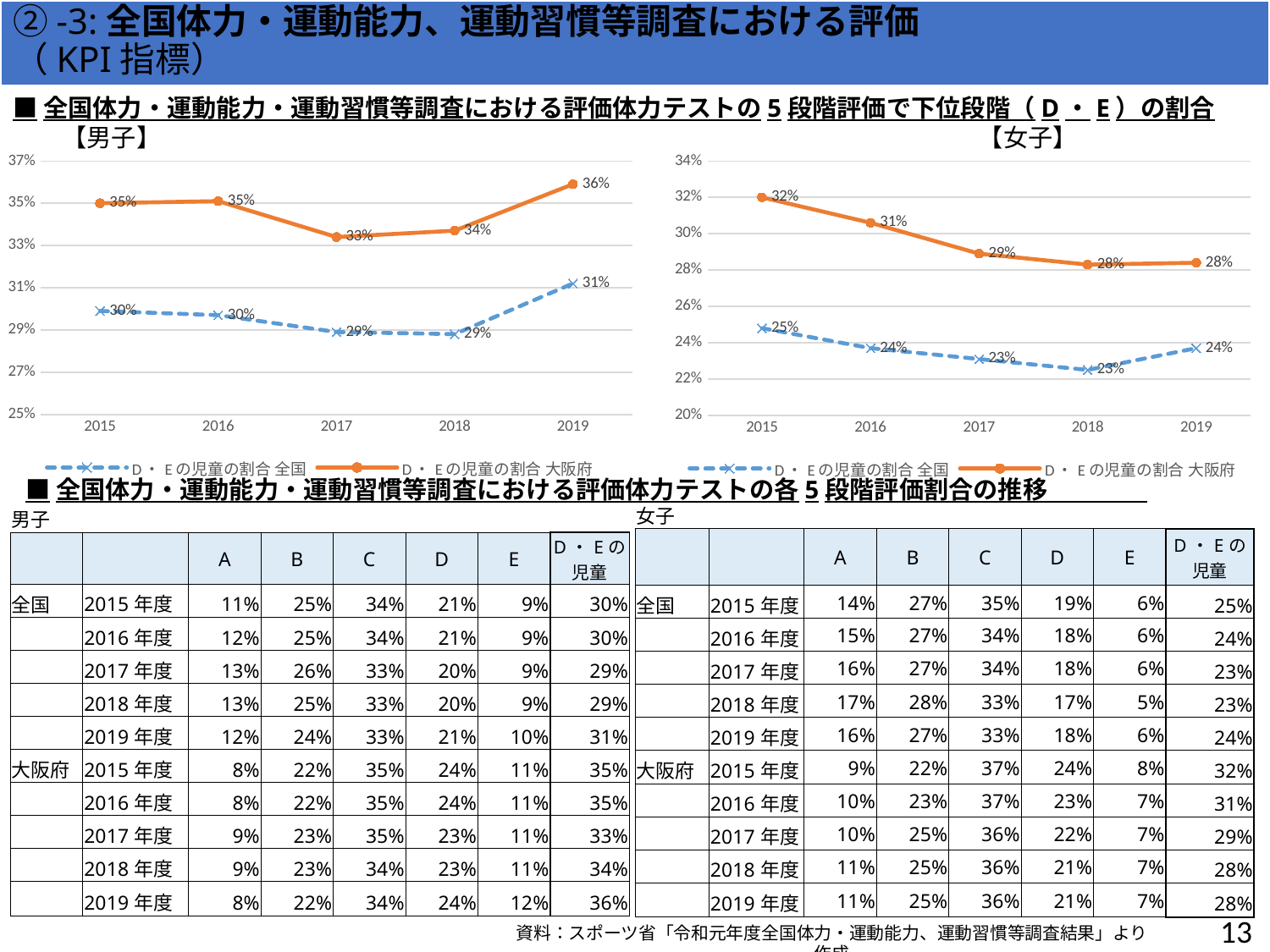
【女子】のグラフで、2015年の「D・Eの児童の割合 大阪府」の値はいくつですか？ 32% 【男子】のグラフで、2017年の「D・Eの児童の割合 全国」の値はいくつですか？ 29% 【女子】のグラフで、2018年の「D・Eの児童の割合 全国」の値はいくつですか？ 23% 【女子】のグラフで、「D・Eの児童の割合 大阪府」が最も高いのは何年ですか？ 2015 【男子】のグラフはどの種類のグラフですか？ 折れ線グラフ 【男子】のグラフで、2019年の「大阪府」と「全国」の値の差はいくつですか？ 5% 【男子】のグラフの凡例には何系列ありますか？ 2 【男子】のグラフで、2019年の「D・Eの児童の割合 大阪府」の値はいくつですか？ 36% 【女子】のグラフで、2015年の「大阪府」と「全国」の値の差はいくつですか？ 7% 【女子】のグラフで、「D・Eの児童の割合 大阪府」は2015年から2019年にかけて上昇していますか、下降していますか？ 下降 【男子】のグラフで、「D・Eの児童の割合 大阪府」が最も高いのは何年ですか？ 2019 【女子】のグラフで、2016年の「大阪府」と「全国」ではどちらの値が大きいですか？ 大阪府